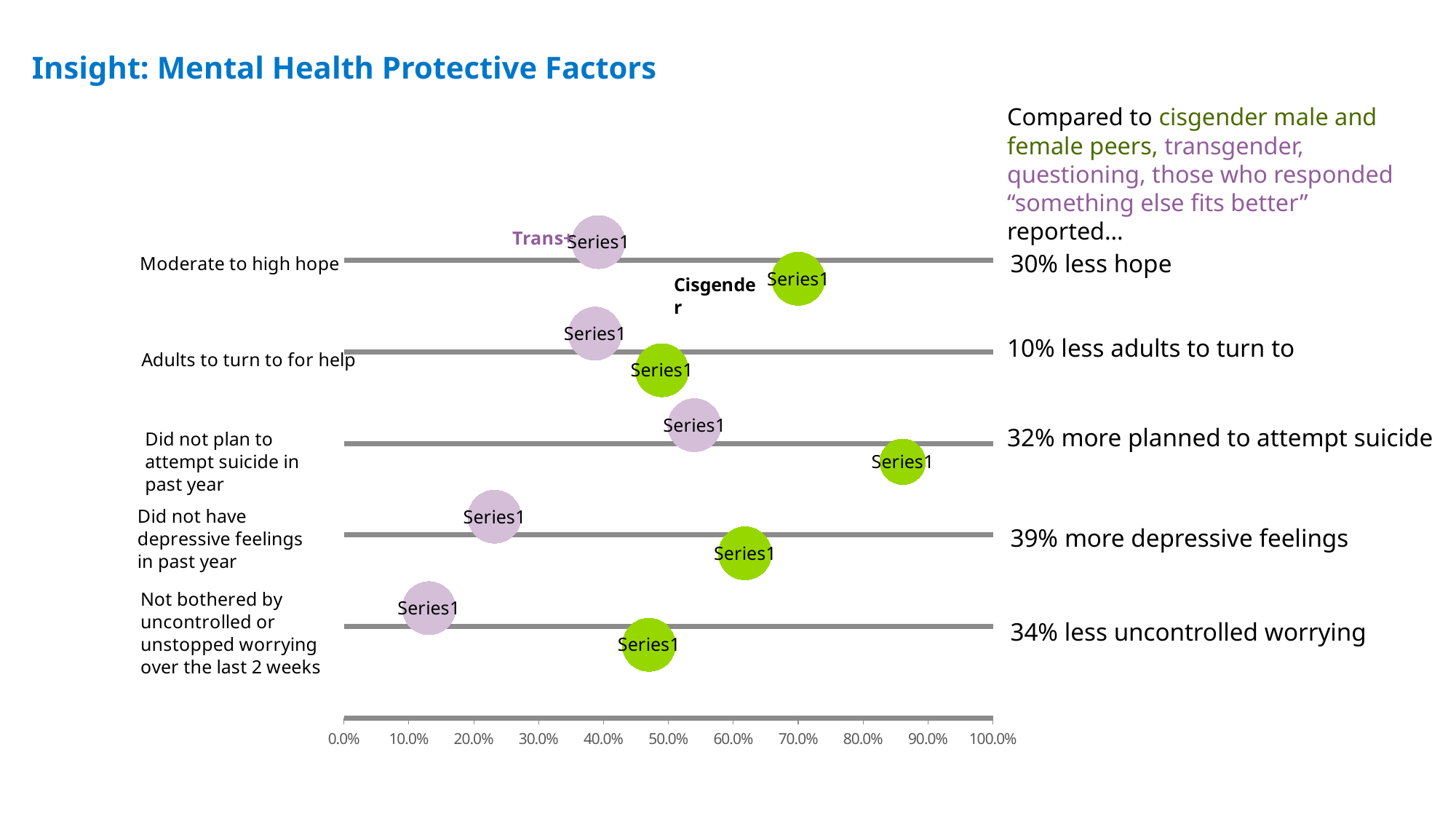
Is the Trans+ value for Moderate to high hope greater or less than 50.0%? less How many categories are plotted on the chart? 5 For Adults to turn to for help, which group has the lower value, Trans+ or Cisgender? Trans+ What colour are the Cisgender markers on the chart? Green Which category has the highest Cisgender value? Did not plan to attempt suicide in past year Which category has the lowest Trans+ value? Not bothered by uncontrolled or unstopped worrying over the last 2 weeks Is the Trans+ value for Not bothered by uncontrolled or unstopped worrying over the last 2 weeks greater or less than 20.0%? less Is the Cisgender value for Did not plan to attempt suicide in past year greater or less than 80.0%? greater How many groups (series) are plotted on the chart? 2 For Did not have depressive feelings in past year, which group has the higher value, Trans+ or Cisgender? Cisgender